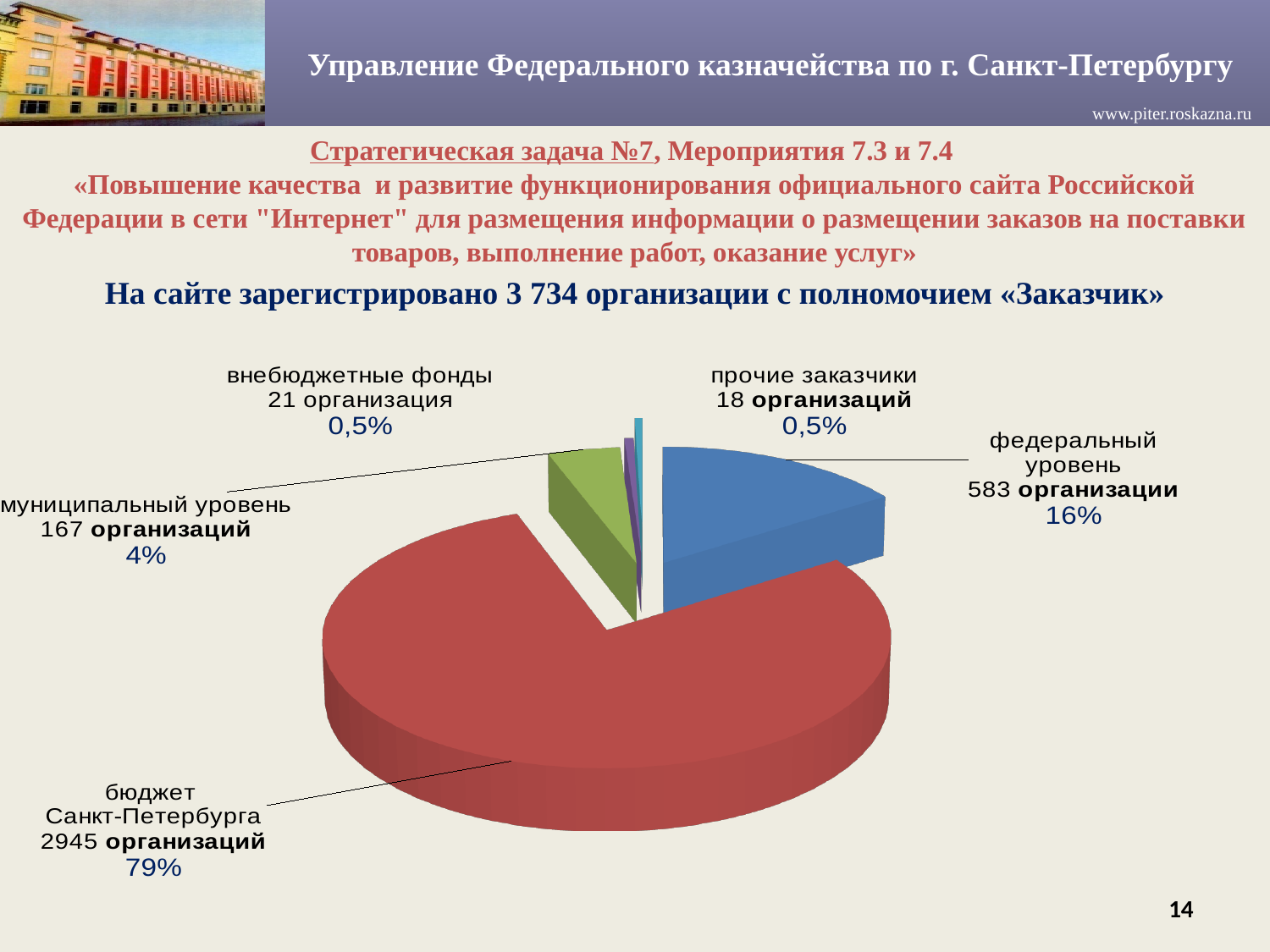
How many slices does the pie chart have? 5 What share of the pie does "муниципальный уровень" take? 4% What share of the pie does "федеральный уровень" take? 16% Which category has the smallest number of organisations? прочие заказчики Which category has the largest slice of the pie? бюджет Санкт-Петербурга Which has more organisations: "внебюджетные фонды" or "прочие заказчики"? внебюджетные фонды How many organisations are in the "бюджет Санкт-Петербурга" slice? 2945 How many organisations are in the "муниципальный уровень" slice? 167 What colour is the "федеральный уровень" slice? blue What is the difference in the number of organisations between "федеральный уровень" and "муниципальный уровень"? 416 What percentage is shown for "внебюджетные фонды"? 0,5% What kind of chart is shown on the slide? pie chart